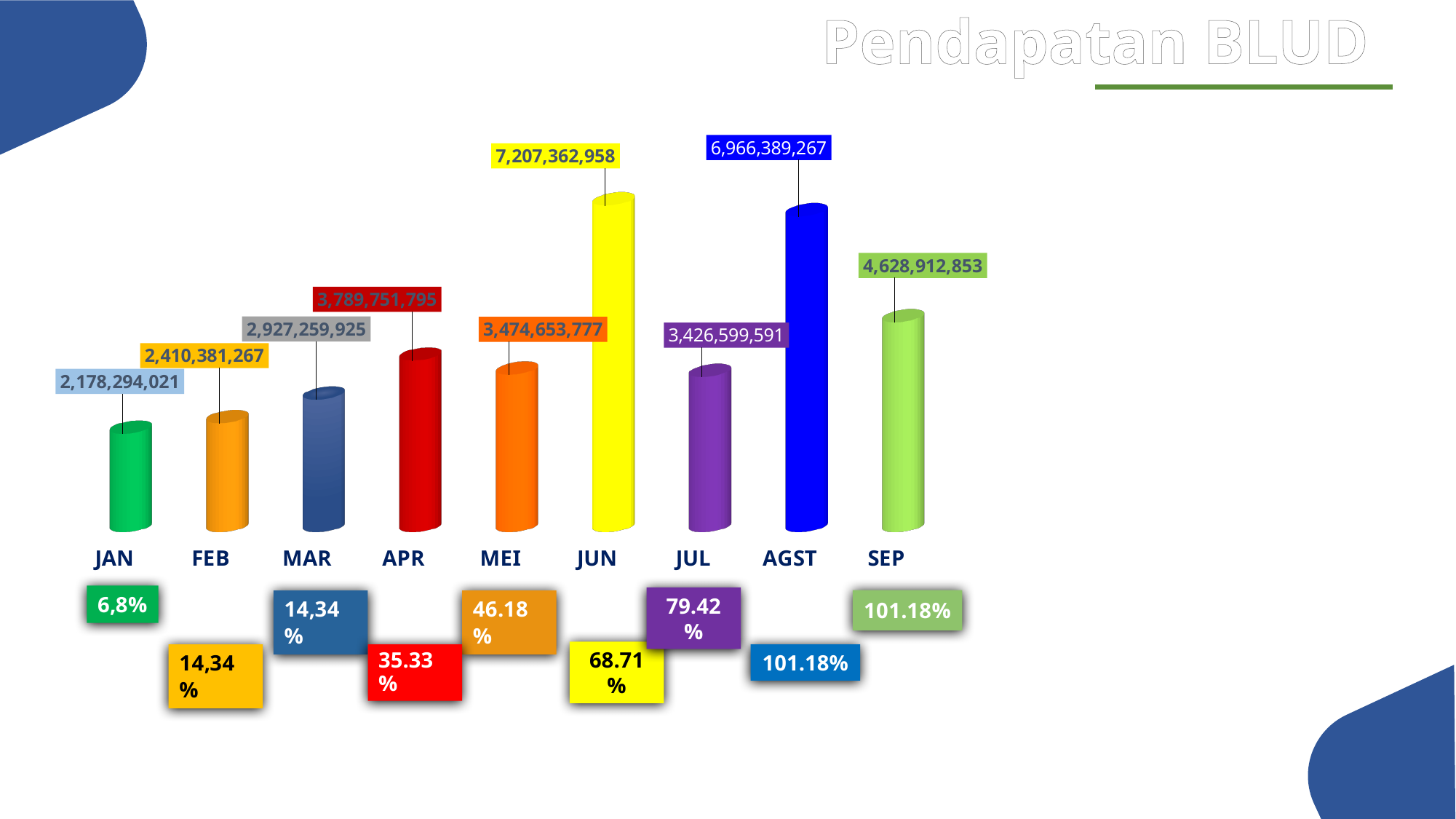
Which month has the lowest value? JAN What is the value for SEP? 4,628,912,853 Which is larger, the value for APR or the value for MAR? APR What is the value for JAN? 2,178,294,021 What is the difference between the values for JUN and AGST? 240,973,691 Which month has the highest value? JUN What is the value for JUN? 7,207,362,958 Do the values rise or fall from JAN to APR? Rise What kind of chart is shown on the slide? Bar chart How many months are shown on the chart? 9 What is the difference between the values for FEB and JAN? 232,087,246 What is the value for JUL? 3,426,599,591